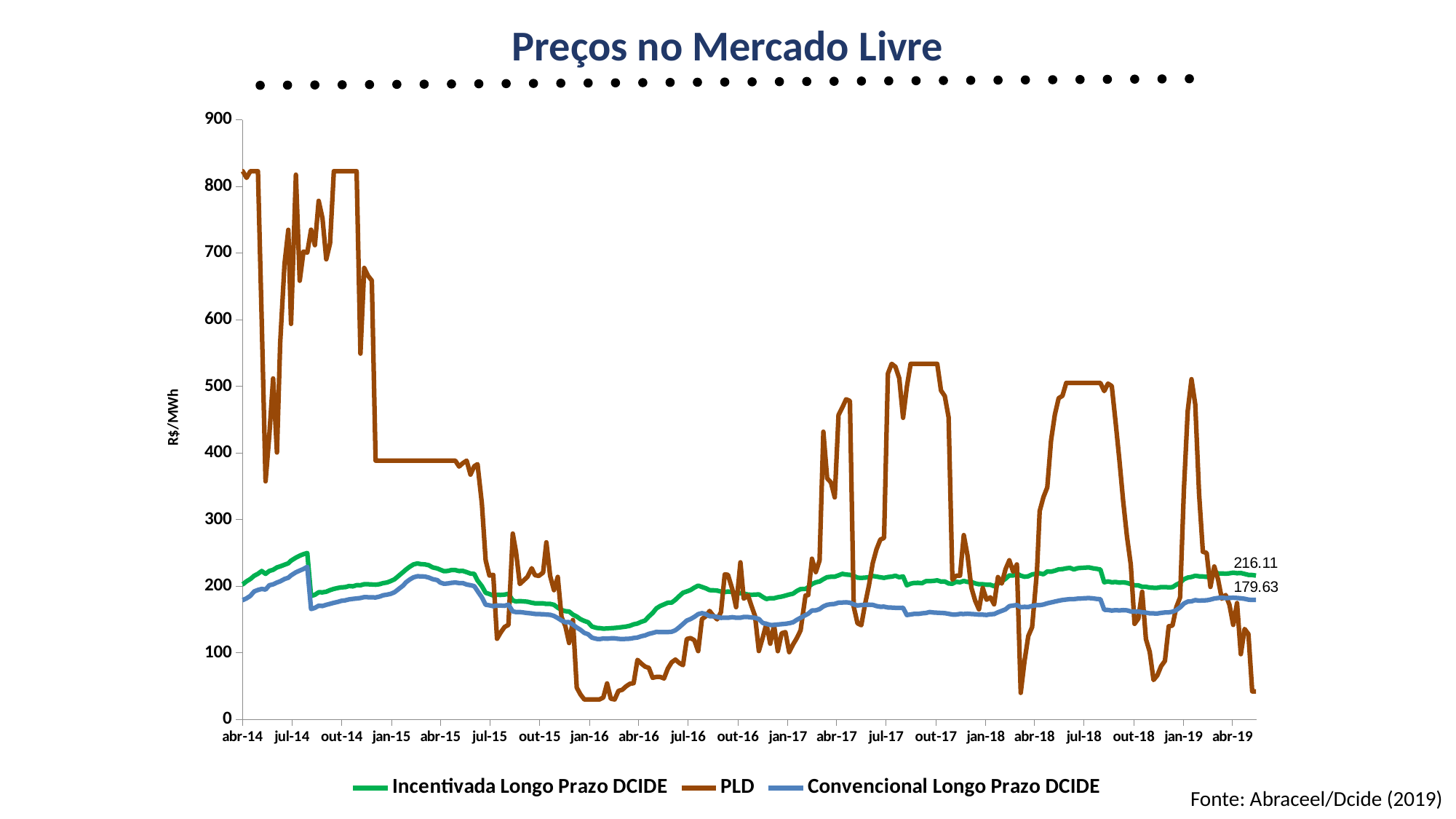
What is the difference between the final labelled values of Incentivada Longo Prazo DCIDE (216.11) and Convencional Longo Prazo DCIDE (179.63)? 36.48 How many series does the legend list? 3 Is the value of PLD at abr-14 greater or less than 800? greater Is the value of PLD at jan-16 greater or less than 100? less What kind of chart is shown on the slide? line chart What is the last labelled value of the Convencional Longo Prazo DCIDE series? 179.63 What is the label on the vertical axis? R$/MWh What is the last labelled value of the Incentivada Longo Prazo DCIDE series? 216.11 Which series reaches the highest value anywhere on the chart? PLD Does the PLD series rise or fall overall between abr-14 and jan-16? fall At the end of the series, which is higher: Incentivada Longo Prazo DCIDE or Convencional Longo Prazo DCIDE? Incentivada Longo Prazo DCIDE Is the value of Incentivada Longo Prazo DCIDE at abr-16 greater or less than 200? less